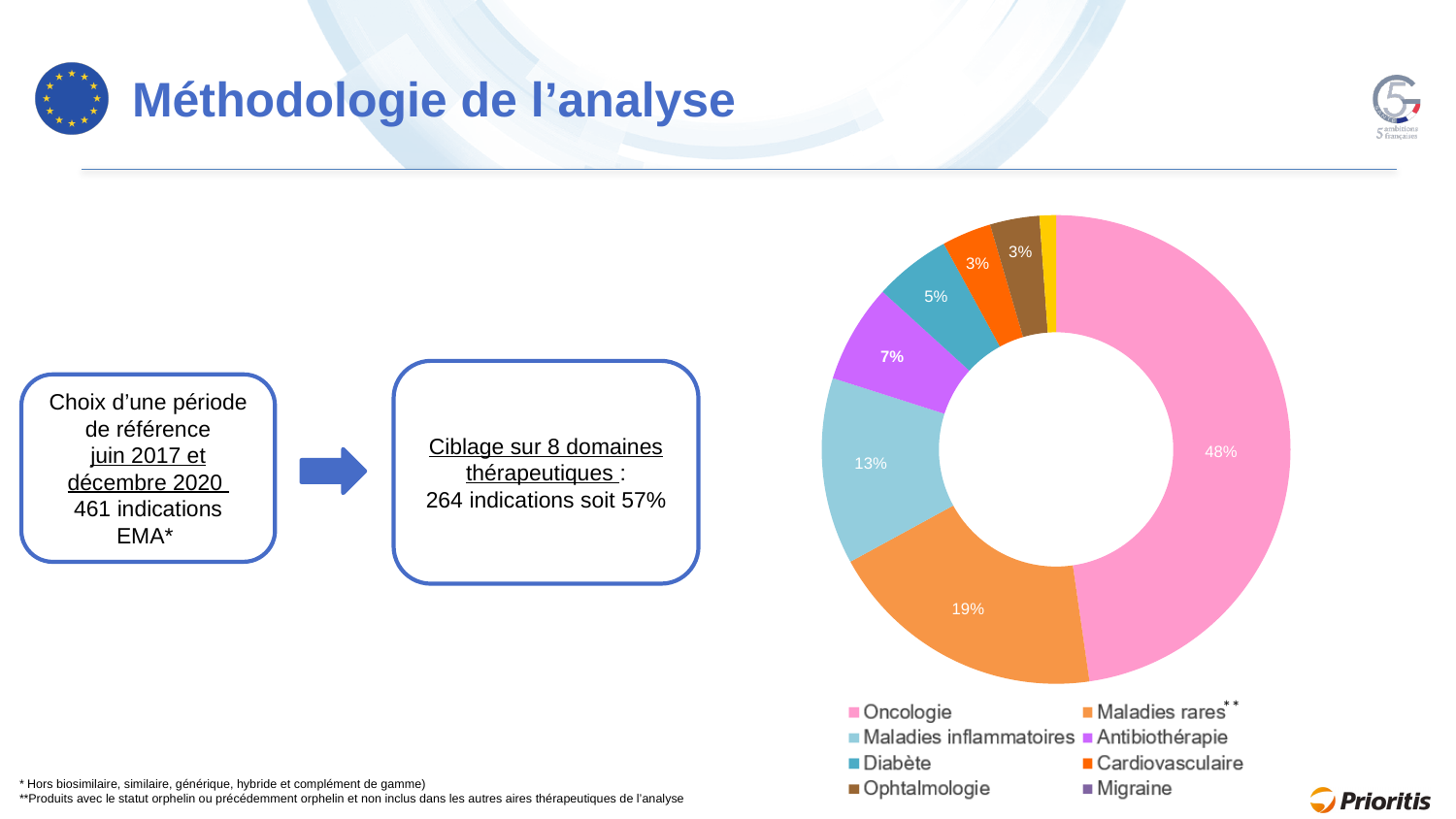
Which is larger in the pie chart, Maladies inflammatoires or Antibiothérapie? Maladies inflammatoires What is the value shown for Maladies rares in the pie chart? 19% Which therapeutic area has the smallest slice of the pie chart? Migraine How many therapeutic areas are shown in the pie chart? 8 What type of chart is shown on the slide? Pie chart (doughnut) What percentage is shown for Diabète? 5% How many percentage points larger is the Oncologie slice than the Maladies rares slice? 29 Which colour represents Oncologie in the pie chart? Pink What percentage is shown for Antibiothérapie? 7% What share does Maladies inflammatoires have in the pie chart? 13% What percentage of the pie chart does Oncologie represent? 48% Which therapeutic area has the largest slice of the pie chart? Oncologie